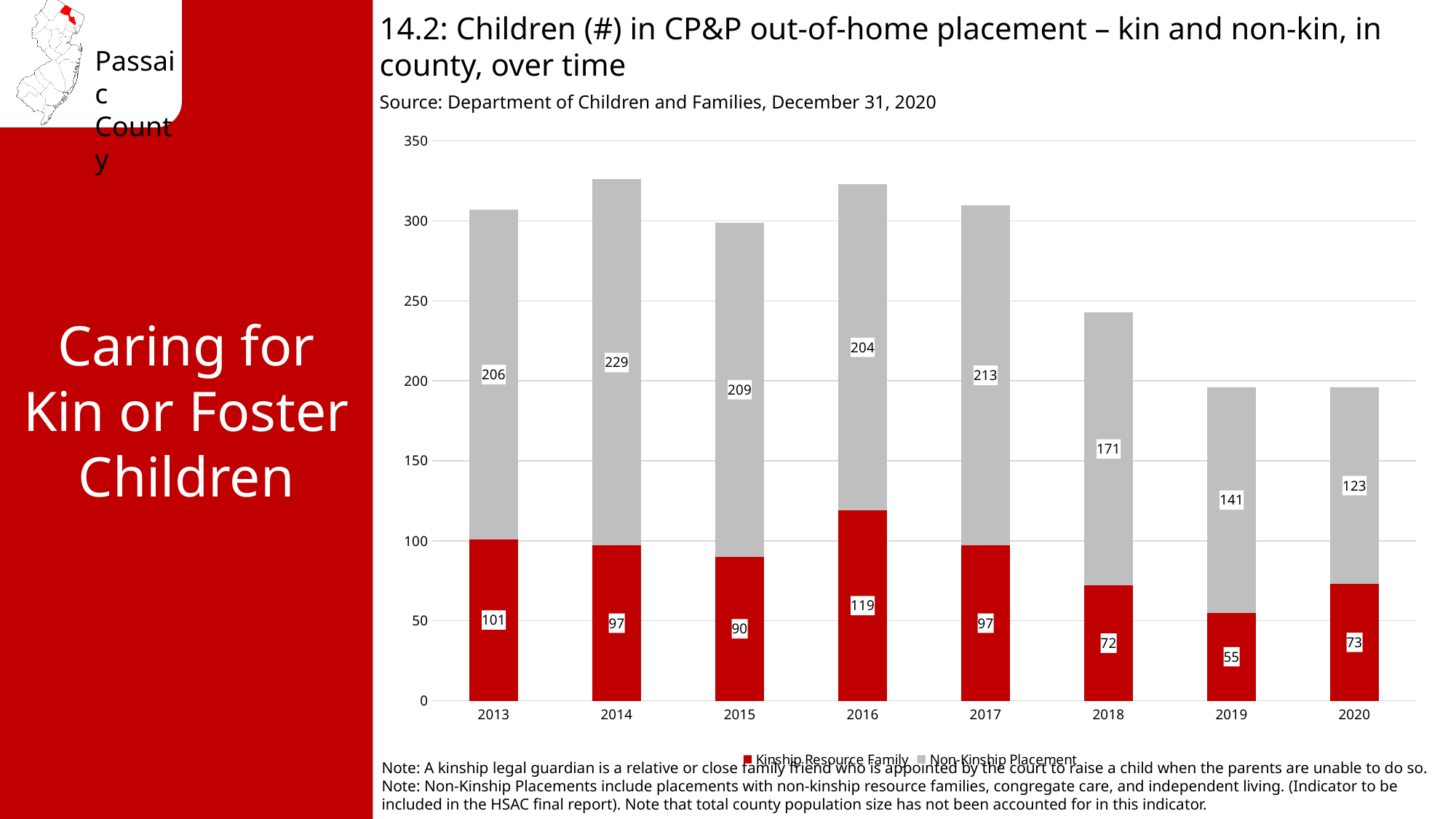
Does the Non-Kinship Placement value rise or fall from 2017 to 2020? Fall What type of chart is shown on the slide? Stacked bar chart What is the total number of children in out-of-home placement in 2014? 326 Which is larger, the Kinship Resource Family value for 2013 or for 2018? 2013 Which year has the lowest Kinship Resource Family value? 2019 What is the Kinship Resource Family value for 2016? 119 Which year has the highest Non-Kinship Placement value? 2014 What is the difference between the Non-Kinship Placement values for 2017 and 2020? 90 How many series does the legend list? 2 Is the total for 2018 greater or less than 250? less How many years are shown on the x axis? 8 What is the Non-Kinship Placement value for 2019? 141